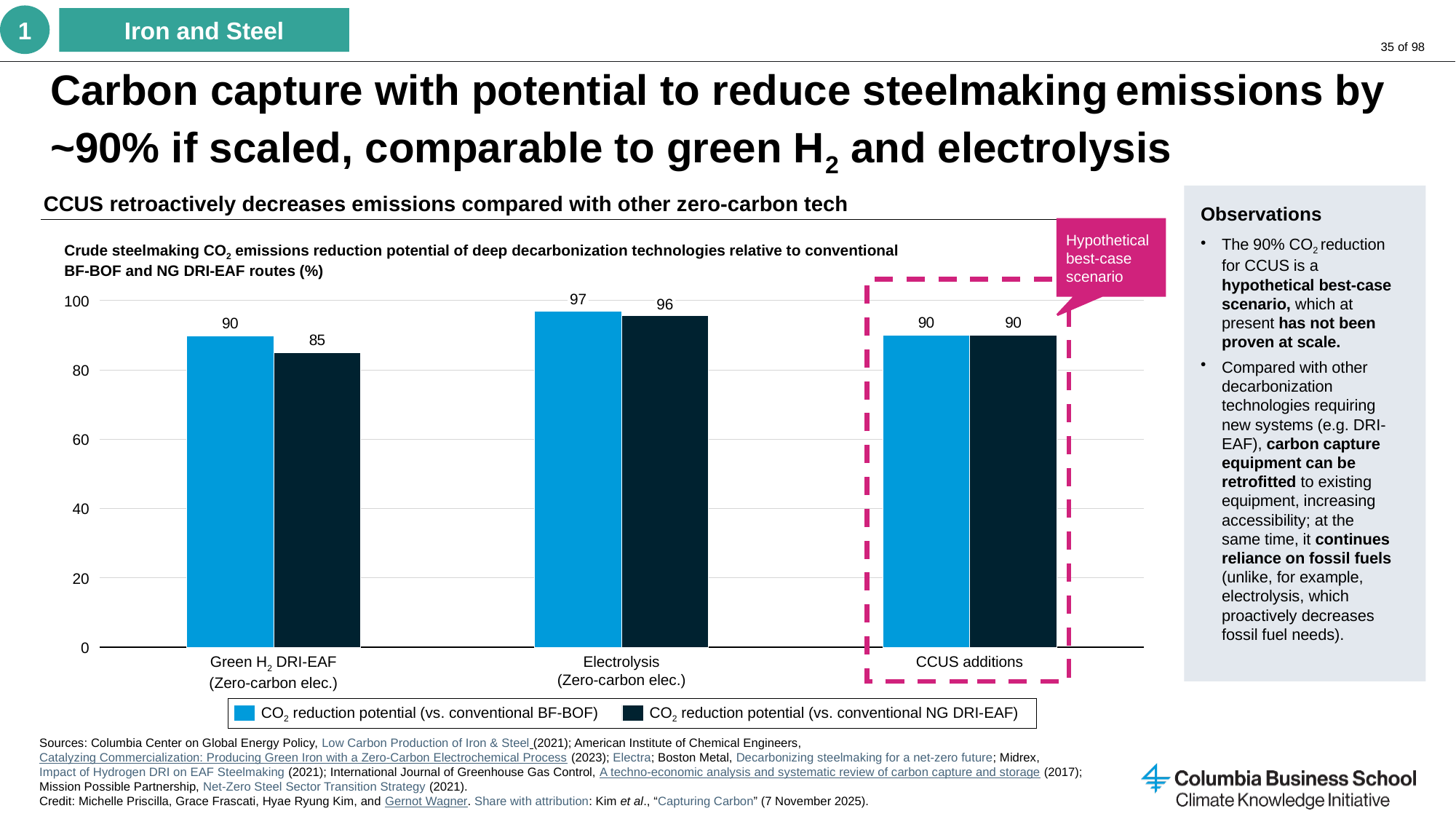
For Green H2 DRI-EAF, which is larger: the reduction potential vs. conventional BF-BOF or vs. conventional NG DRI-EAF? vs. conventional BF-BOF What is the CO2 reduction potential (vs. conventional BF-BOF) for Green H2 DRI-EAF? 90 Which technology has the lowest CO2 reduction potential vs. conventional NG DRI-EAF? Green H2 DRI-EAF How many series does the legend list? 2 Which technology has the highest CO2 reduction potential vs. conventional BF-BOF? Electrolysis How many technology categories are shown on the x axis? 3 What is the difference between the Electrolysis and Green H2 DRI-EAF values for CO2 reduction potential vs. conventional NG DRI-EAF? 11 Which category is highlighted with a dashed box labelled 'Hypothetical best-case scenario'? CCUS additions What kind of chart is shown on the slide? Bar chart What is the CO2 reduction potential (vs. conventional BF-BOF) for Electrolysis? 97 What is the CO2 reduction potential (vs. conventional NG DRI-EAF) for Green H2 DRI-EAF? 85 What is the CO2 reduction potential (vs. conventional NG DRI-EAF) for CCUS additions? 90